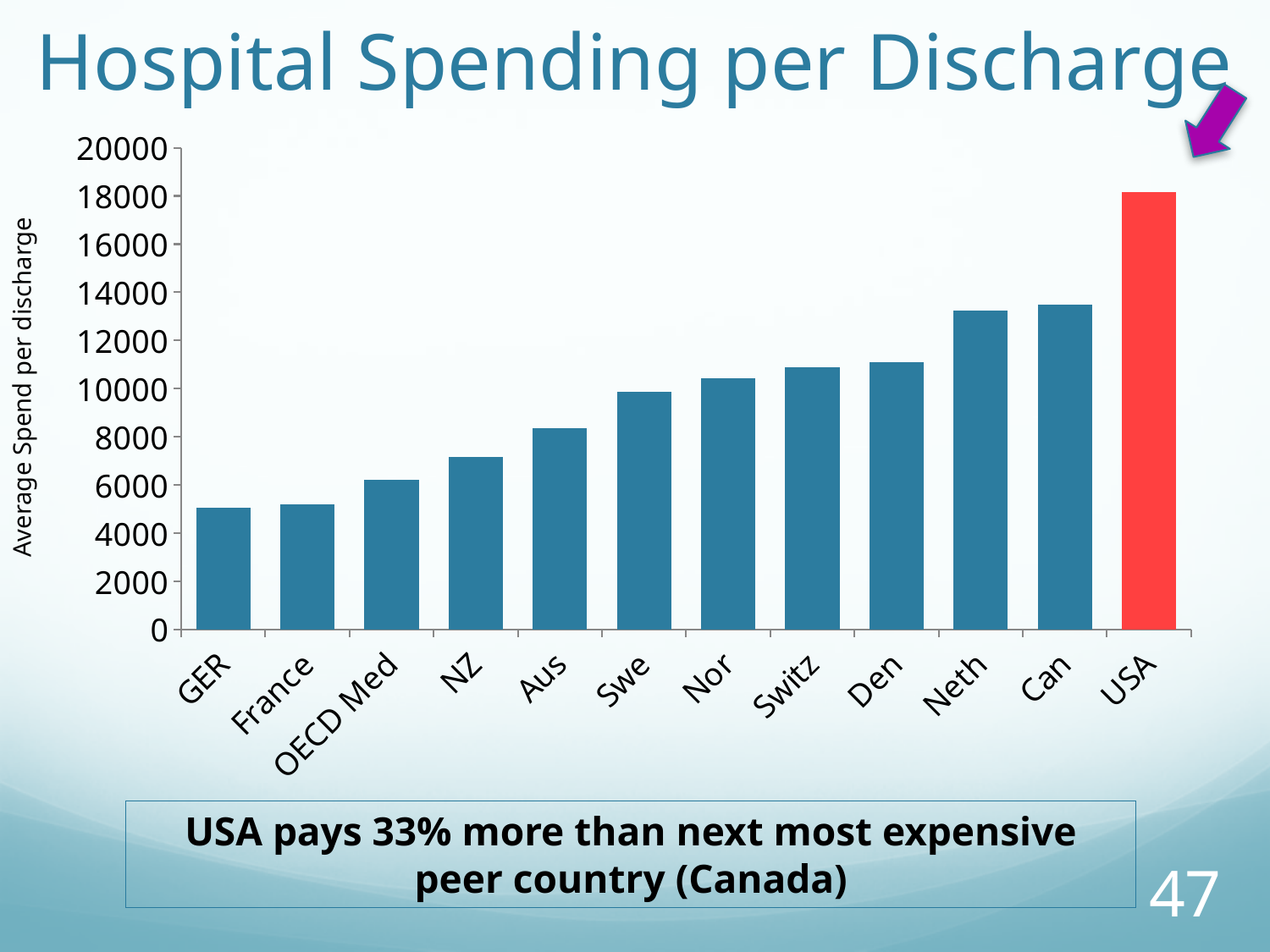
What colour is the bar for USA? red What kind of chart is shown on the slide? bar chart Is the value for Neth greater or less than 12000? greater Which is larger, the value for USA or the value for Can? USA Which category has the highest average spend per discharge? USA Which is larger, the value for Neth or the value for Aus? Neth Is the value for NZ greater or less than 8000? less Is the value for Den greater or less than 10000? greater How many countries or categories are shown on the x axis of the chart? 12 Do the values generally rise or fall moving from left to right along the x axis? rise